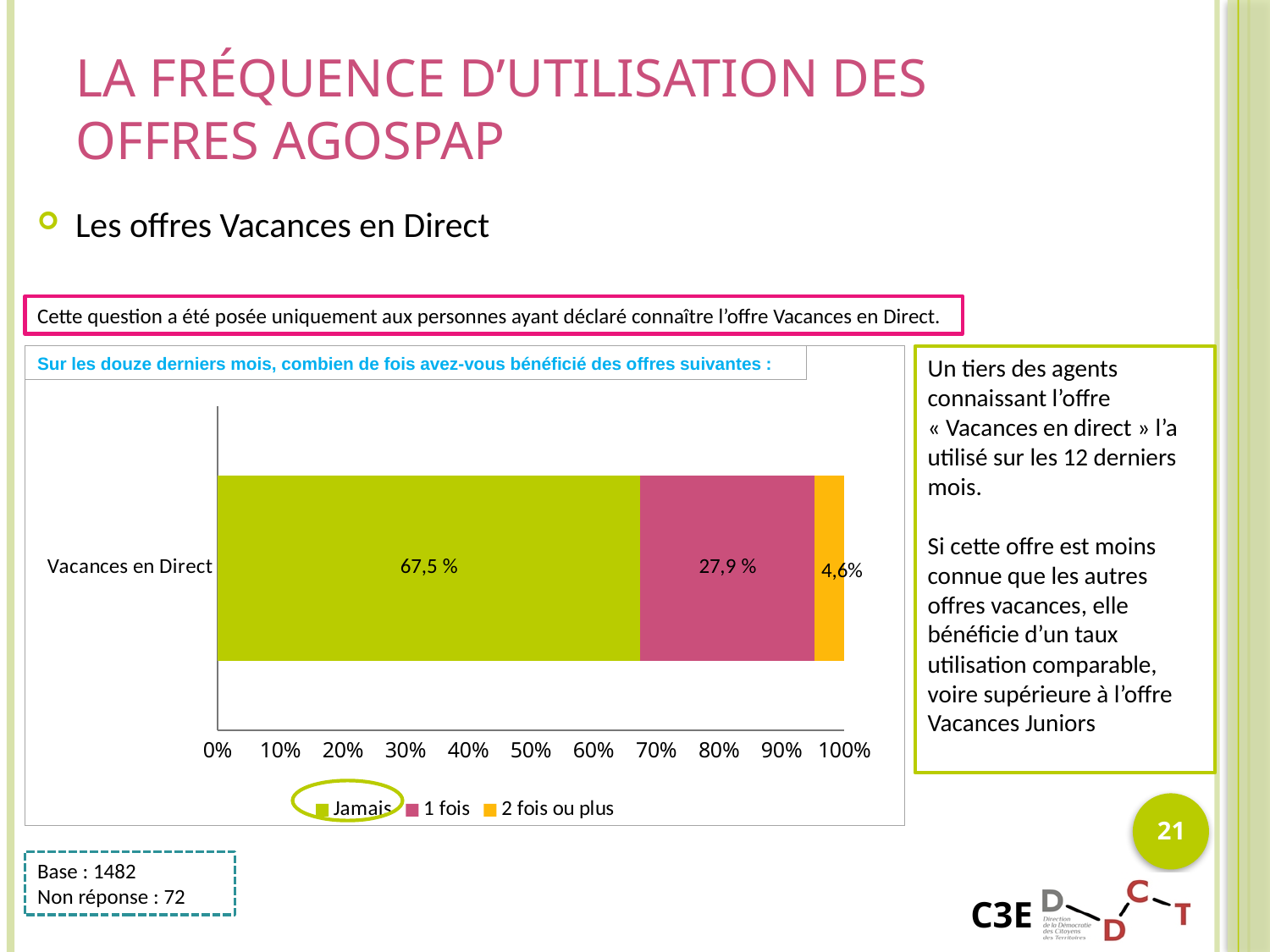
What is the value for "2 fois ou plus" for Vacances en Direct? 4,6% What is the value for "1 fois" for Vacances en Direct? 27,9 % What is the value for "Jamais" for Vacances en Direct? 67,5 % What type of chart is shown on the slide? Stacked bar chart Which series has the smallest share of the Vacances en Direct bar? 2 fois ou plus How many series does the legend list? 3 What is the total of the stacked bar for Vacances en Direct? 100 % What is the difference between the "Jamais" and "1 fois" values? 39,6 points Which series has the largest share of the Vacances en Direct bar? Jamais Which is larger, the "1 fois" value or the "2 fois ou plus" value? 1 fois How many categories are plotted on the y axis? 1 Is the value for "Jamais" greater or less than 60%? greater